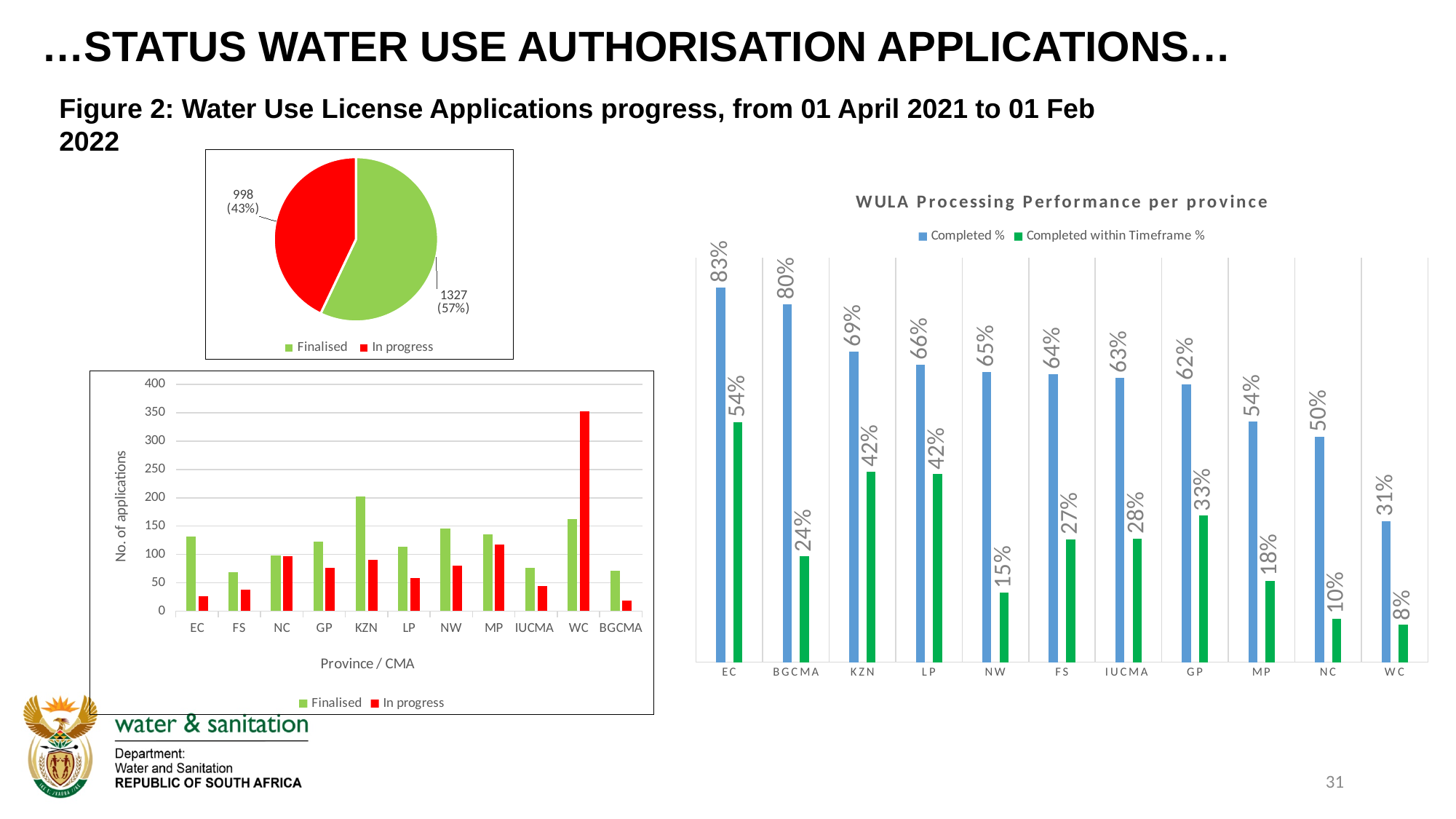
In the WULA Processing Performance per province chart, which province has the lowest Completed within Timeframe %? WC In the WULA Processing Performance per province chart, what is the difference between the Completed % and the Completed within Timeframe % for EC? 29 percentage points In the pie chart at the top left, what value is shown for the Finalised slice? 1327 (57%) In the bottom-left chart of No. of applications by Province / CMA, is the In progress value for WC greater or less than 300? greater In the WULA Processing Performance per province chart, which province has the highest Completed %? EC In the pie chart at the top left, which slice is larger, Finalised or In progress? Finalised In the WULA Processing Performance per province chart, how many series does the legend list? 2 In the WULA Processing Performance per province chart, what is the Completed within Timeframe % for NW? 15% In the bottom-left chart of No. of applications by Province / CMA, how many provinces/CMAs are shown on the x axis? 11 In the WULA Processing Performance per province chart, does the Completed % rise or fall from EC to WC along the x axis? Fall In the pie chart at the top left, what share of applications is In progress? 43% In the WULA Processing Performance per province chart, what is the Completed % for KZN? 69%